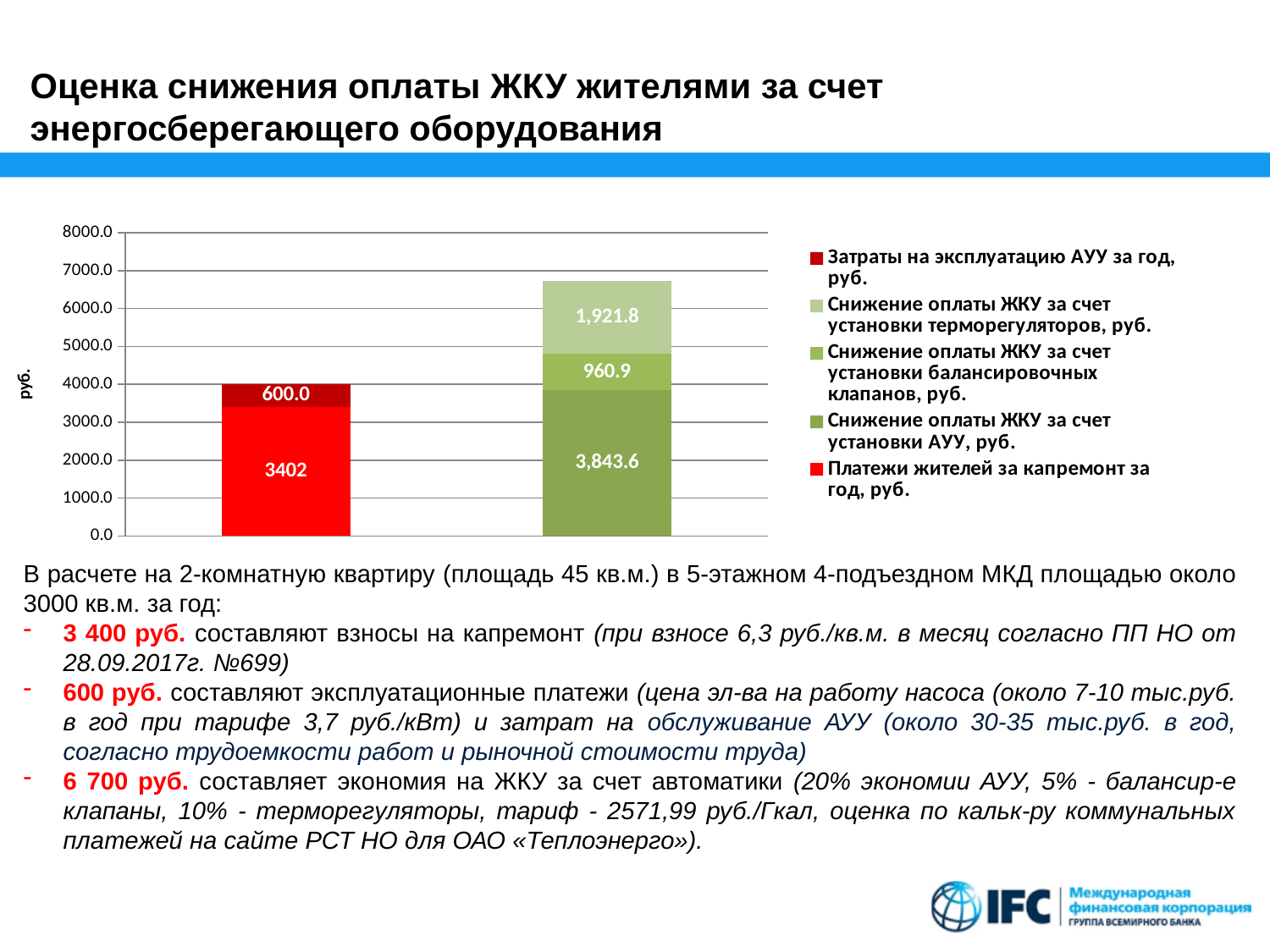
What kind of chart is shown on the slide? stacked bar chart How many series does the chart legend list? 5 What is the value of the series 'Снижение оплаты ЖКУ за счет установки терморегуляторов, руб.' in the right bar? 1,921.8 What is the total of the left stacked bar? 4002.0 What is the value of the series 'Снижение оплаты ЖКУ за счет установки балансировочных клапанов, руб.' in the right bar? 960.9 What is the value of the series 'Затраты на эксплуатацию АУУ за год, руб.' in the left bar? 600.0 What is the total of the right stacked bar? 6,726.3 What is the difference between the value for 'Снижение оплаты ЖКУ за счет установки АУУ, руб.' and the value for 'Платежи жителей за капремонт за год, руб.'? 441.6 Which is larger: the value for 'Снижение оплаты ЖКУ за счет установки терморегуляторов, руб.' or the value for 'Снижение оплаты ЖКУ за счет установки балансировочных клапанов, руб.'? Снижение оплаты ЖКУ за счет установки терморегуляторов, руб. How many bars are plotted in the chart? 2 What is the value of the series 'Платежи жителей за капремонт за год, руб.' in the left bar? 3402 What is the value of the series 'Снижение оплаты ЖКУ за счет установки АУУ, руб.' in the right bar? 3,843.6